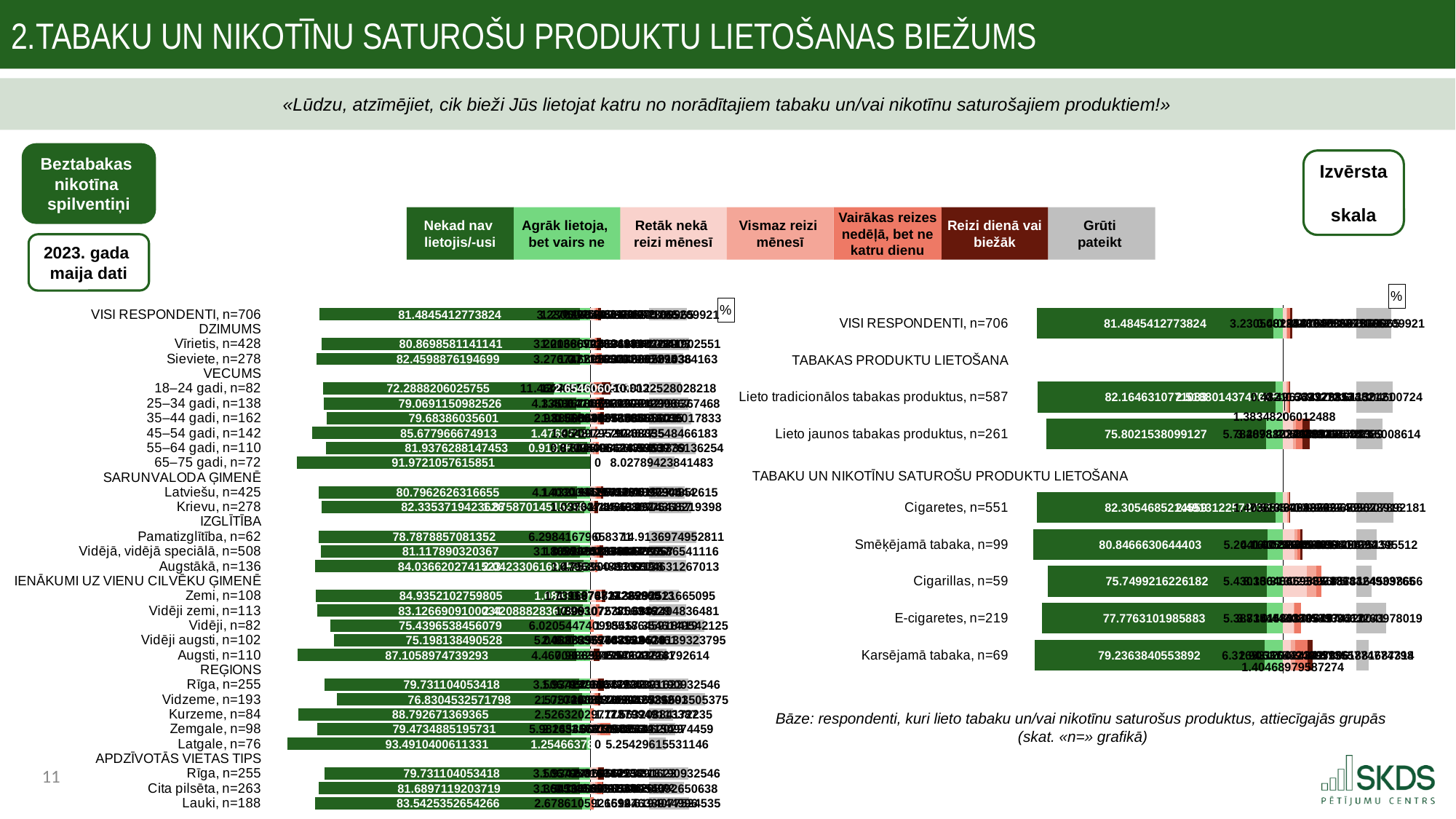
What kind of chart is the right chart? Stacked bar chart On the left chart, what is the value of the 'Nekad nav lietojis/-usi' segment for 'VISI RESPONDENTI, n=706'? 81.4845412773824 How many series does the legend list? 7 On the left chart, which region (REĢIONS group) has the highest 'Nekad nav lietojis/-usi' value? Latgale, n=76 On the left chart, what is the difference between the 'Nekad nav lietojis/-usi' values for '65–75 gadi, n=72' and '18–24 gadi, n=82'? 19.6832851590096 On the left chart, which age group (VECUMS) has the lowest 'Nekad nav lietojis/-usi' value? 18–24 gadi, n=82 On the left chart, which has a larger 'Nekad nav lietojis/-usi' value: 'Kurzeme, n=84' or 'Vidzeme, n=193'? Kurzeme, n=84 On the right chart, which has a larger 'Nekad nav lietojis/-usi' value: 'Smēķējamā tabaka, n=99' or 'Cigarillas, n=59'? Smēķējamā tabaka, n=99 On the left chart, what is the value of the 'Nekad nav lietojis/-usi' segment for '18–24 gadi, n=82'? 72.2888206025755 On the right chart, what is the value of the 'Nekad nav lietojis/-usi' segment for 'E-cigaretes, n=219'? 77.7763101985883 On the left chart, what is the value of the 'Nekad nav lietojis/-usi' segment for 'Latgale, n=76'? 93.4910400611331 On the right chart, what is the value of the 'Nekad nav lietojis/-usi' segment for 'Karsējamā tabaka, n=69'? 79.2363840553892